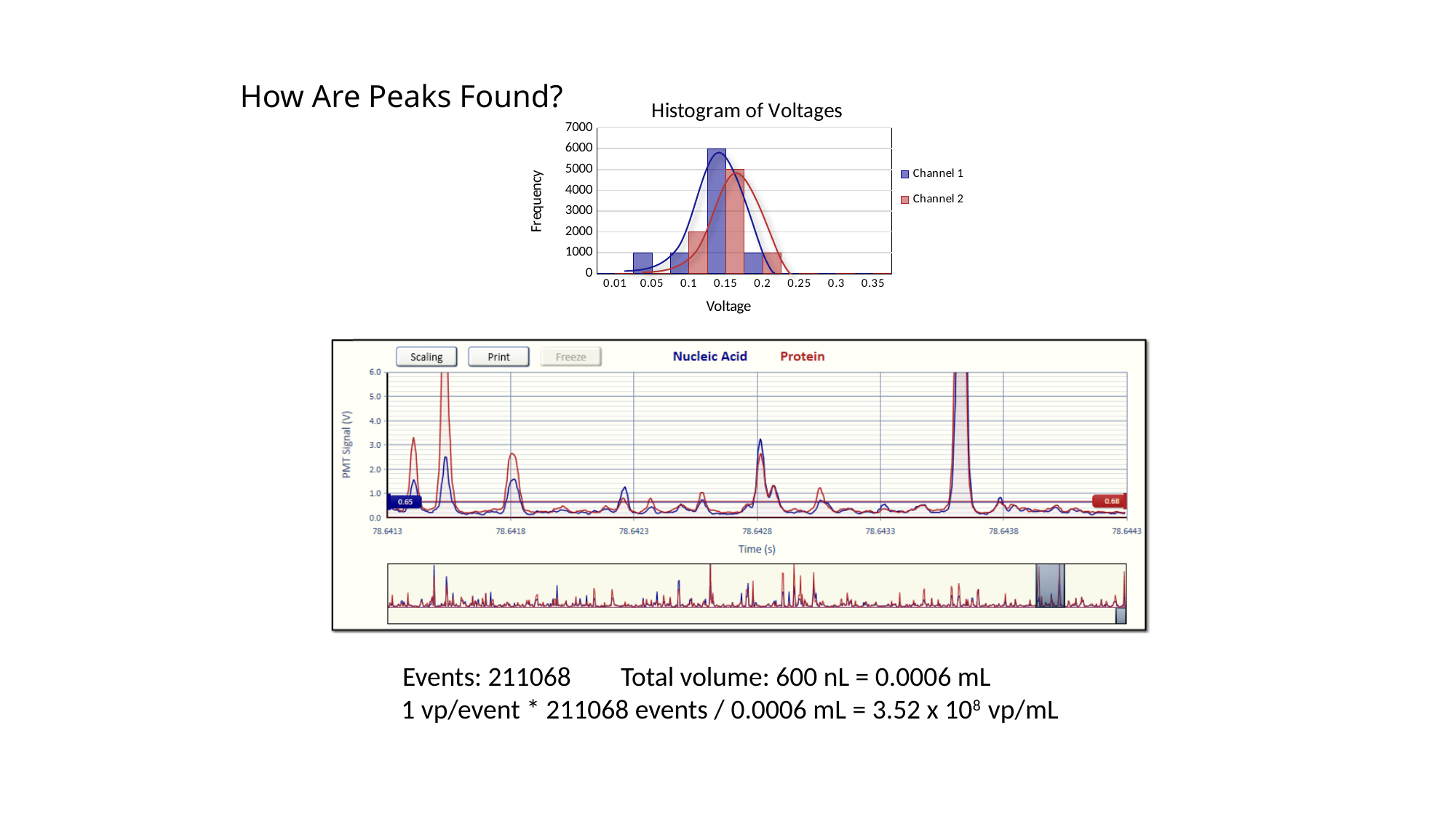
In the Histogram of Voltages, which channel has the higher frequency at 0.15 V? Channel 1 In the Histogram of Voltages, is the Channel 2 frequency at 0.1 V greater or less than 3000? less In the Histogram of Voltages, what is the Channel 1 frequency at 0.15 V? 6000 In the PMT Signal chart at the bottom, is the Nucleic Acid peak near 78.6418 s greater or less than 2.0 V? less In the Histogram of Voltages, what is the Channel 2 frequency at 0.15 V? 5000 In the Histogram of Voltages, how many bars are plotted for Channel 1? 4 In the Histogram of Voltages, is the Channel 1 frequency at 0.15 V greater or less than 5000? greater In the Histogram of Voltages, at which voltage is the Channel 1 frequency highest? 0.15 In the PMT Signal chart at the bottom, what are the two series named? Nucleic Acid, Protein What kind of chart is the Histogram of Voltages? bar chart How many series does the legend of the Histogram of Voltages list? 2 What are the legend entries in the Histogram of Voltages? Channel 1, Channel 2